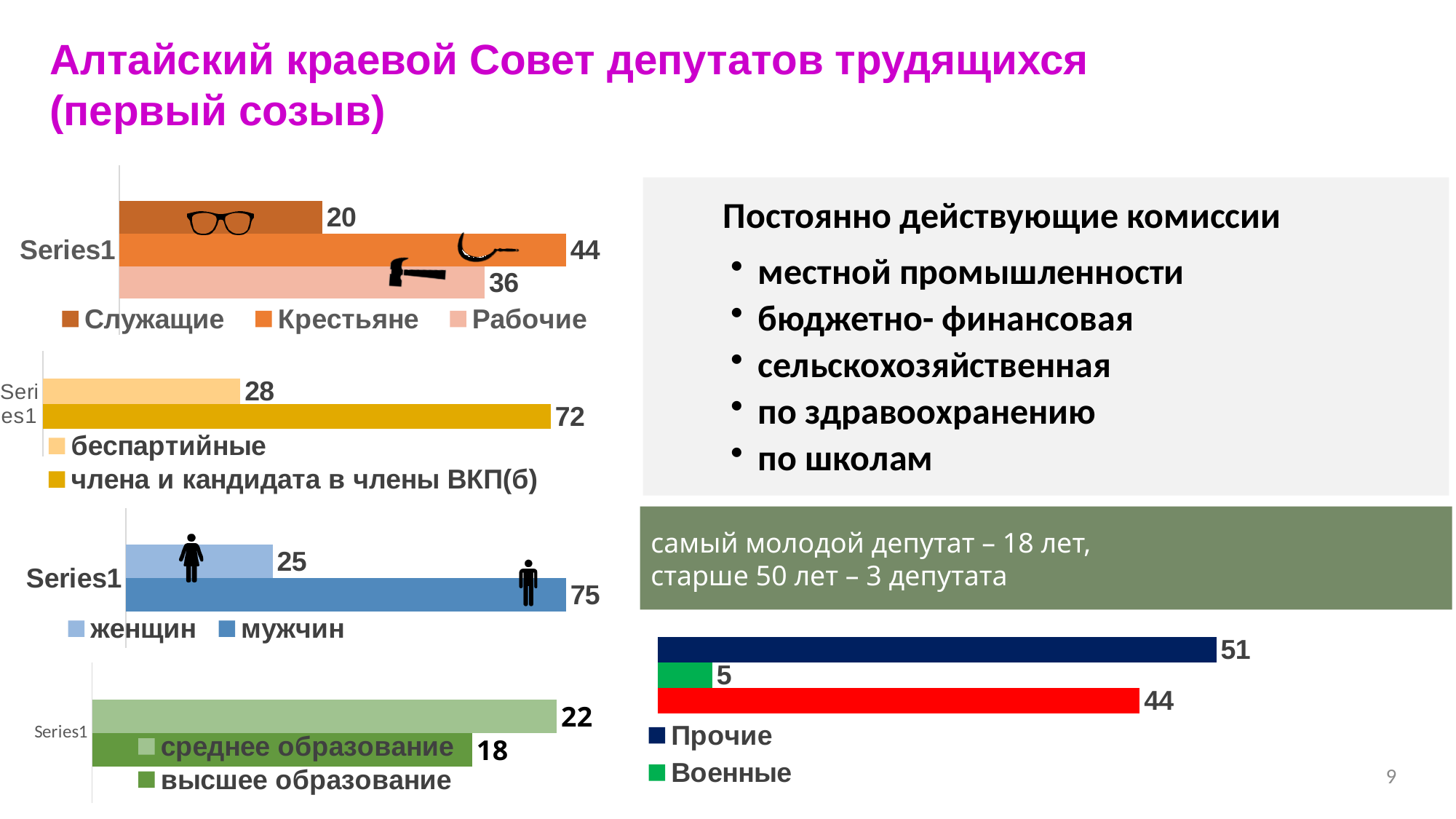
In the top-left chart with the legend Служащие, Крестьяне and Рабочие, what is the value for Крестьяне? 44 In the third chart on the left with the legend женщин and мужчин, what is the difference between мужчин and женщин? 50 What kind of chart is the bottom-right chart with the legend Прочие and Военные? bar chart In the third chart on the left with the legend женщин and мужчин, what is the value for мужчин? 75 In the second chart on the left with the legend беспартийные and члена и кандидата в члены ВКП(б), which series has the higher value? члена и кандидата в члены ВКП(б) In the bottom-right chart with the legend Прочие and Военные, what is the value for Прочие? 51 In the bottom-left chart with the legend среднее образование and высшее образование, what is the value for высшее образование? 18 In the bottom-left chart with the legend среднее образование and высшее образование, which series has the higher value? среднее образование In the top-left chart with the legend Служащие, Крестьяне and Рабочие, which series has the lowest value? Служащие In the top-left chart with the legend Служащие, Крестьяне and Рабочие, how many series does the legend list? 3 In the second chart on the left with the legend беспартийные and члена и кандидата в члены ВКП(б), what is the value for беспартийные? 28 In the top-left chart with the legend Служащие, Крестьяне and Рабочие, what is the difference between Крестьяне and Рабочие? 8